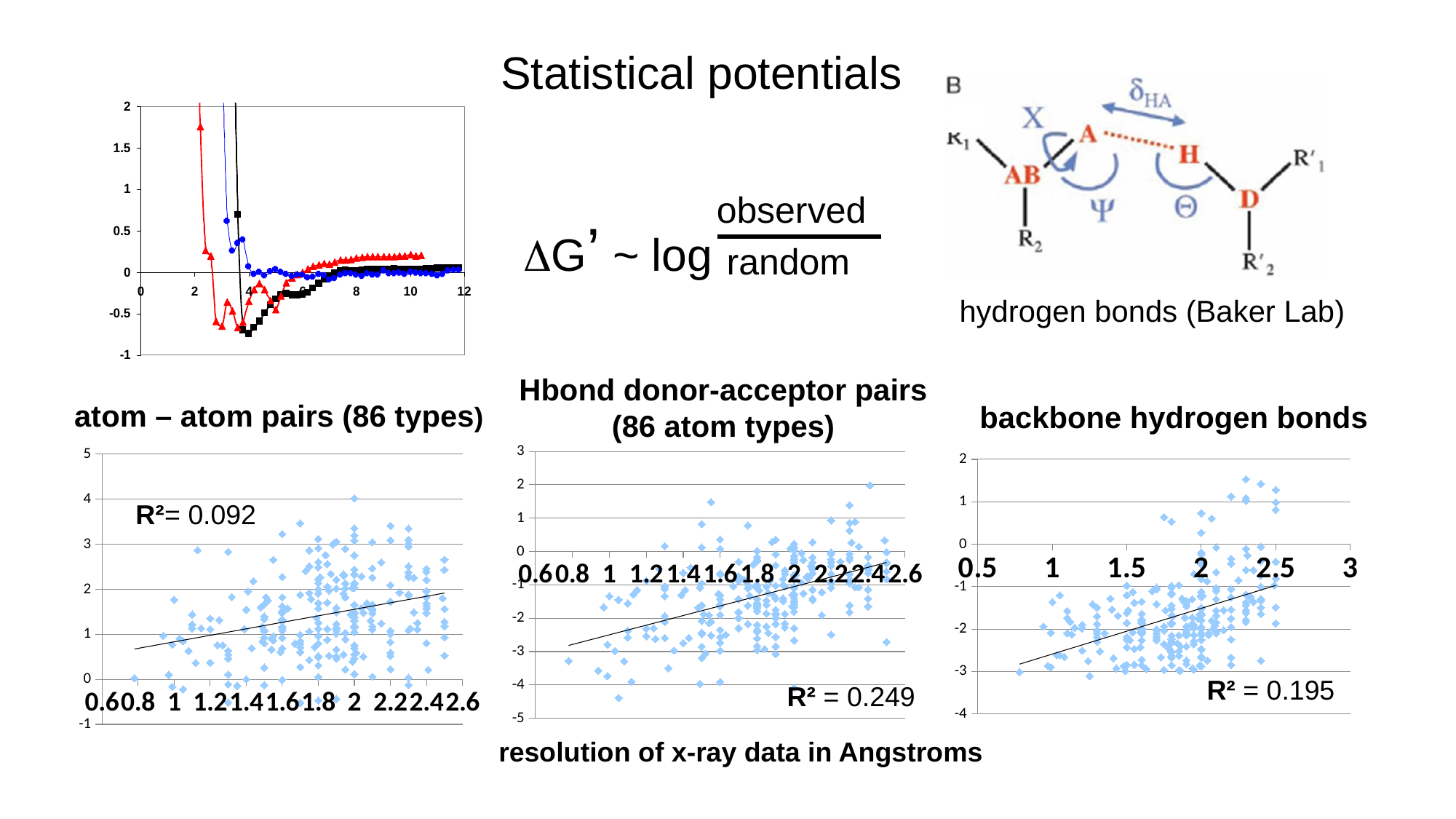
What is the maximum value shown on the x axis of the line chart at the top left of the slide? 12 What kind of chart is the 'atom – atom pairs (86 types)' chart? scatter plot In the 'backbone hydrogen bonds' chart, does the fitted trend line rise or fall as resolution increases along the x axis? rises Is the R² value of the 'backbone hydrogen bonds' chart larger or smaller than that of the 'atom – atom pairs' chart? larger What R² value is printed on the 'backbone hydrogen bonds' chart? 0.195 What R² value is printed on the 'Hbond donor-acceptor pairs (86 atom types)' chart? 0.249 What quantity is plotted on the x axis of the three scatter plots at the bottom of the slide? resolution of x-ray data in Angstroms How many data series are plotted in the line chart at the top left of the slide? 3 What R² value is printed on the 'atom – atom pairs (86 types)' chart? 0.092 Which of the three scatter plots has the highest R² value? Hbond donor-acceptor pairs (86 atom types) What is the difference between the R² values of the 'Hbond donor-acceptor pairs' chart and the 'backbone hydrogen bonds' chart? 0.054 Which of the three scatter plots has the lowest R² value? atom – atom pairs (86 types)